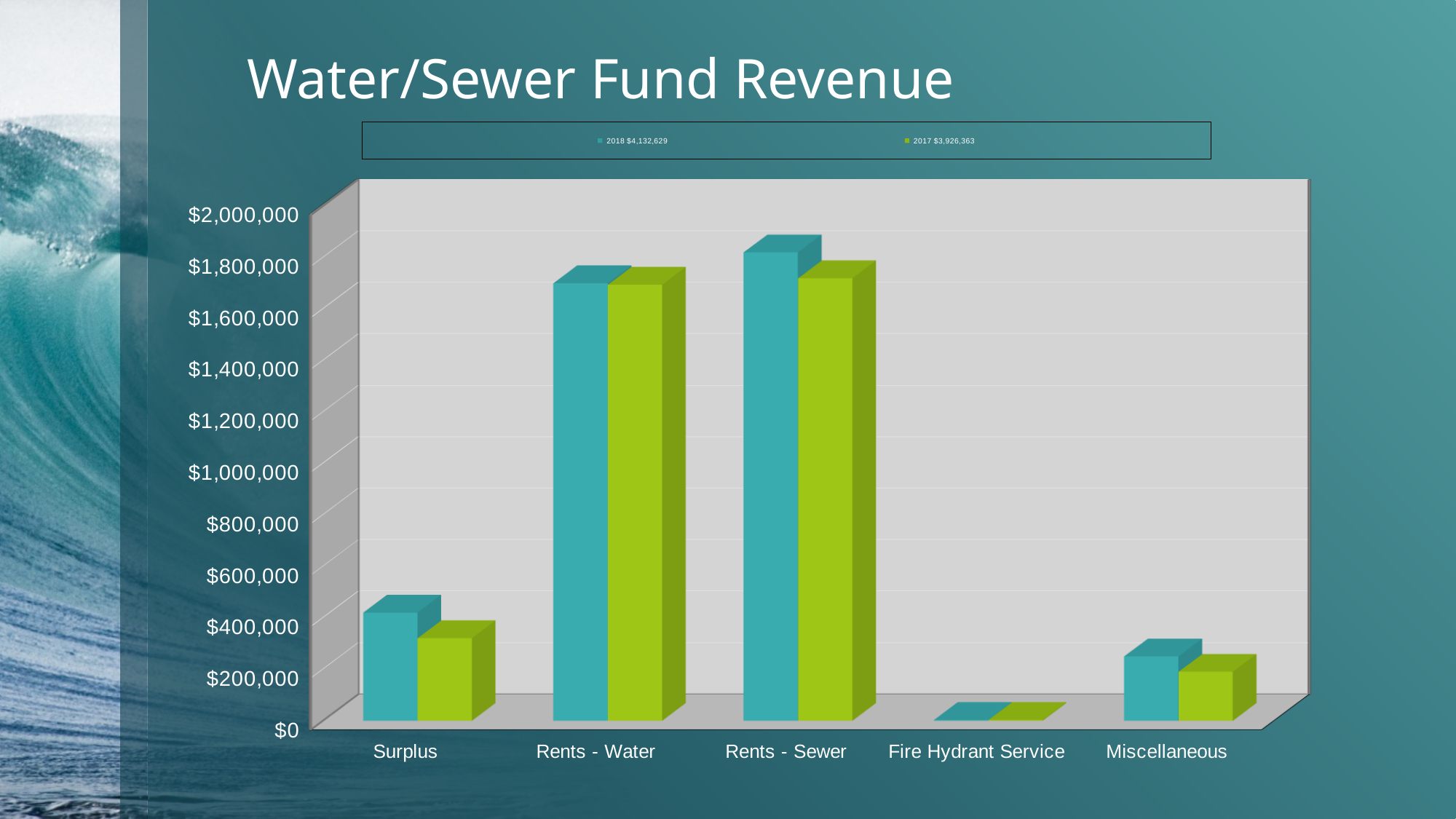
Which category has the lowest value for the 2018 series? Fire Hydrant Service For Surplus, which series has the larger value, 2018 or 2017? 2018 How many series does the chart's legend list? 2 Is the 2017 value for Fire Hydrant Service greater or less than $200,000? less For the 2018 series, which is larger, Rents - Sewer or Rents - Water? Rents - Sewer Which category has the highest value for the 2018 series? Rents - Sewer What is the title of the slide's chart? Water/Sewer Fund Revenue How many categories are shown on the x axis of the chart? 5 Is the 2018 value for Surplus greater or less than $600,000? less Is the 2017 value for Miscellaneous greater or less than $400,000? less What kind of chart is shown on the slide? Bar chart